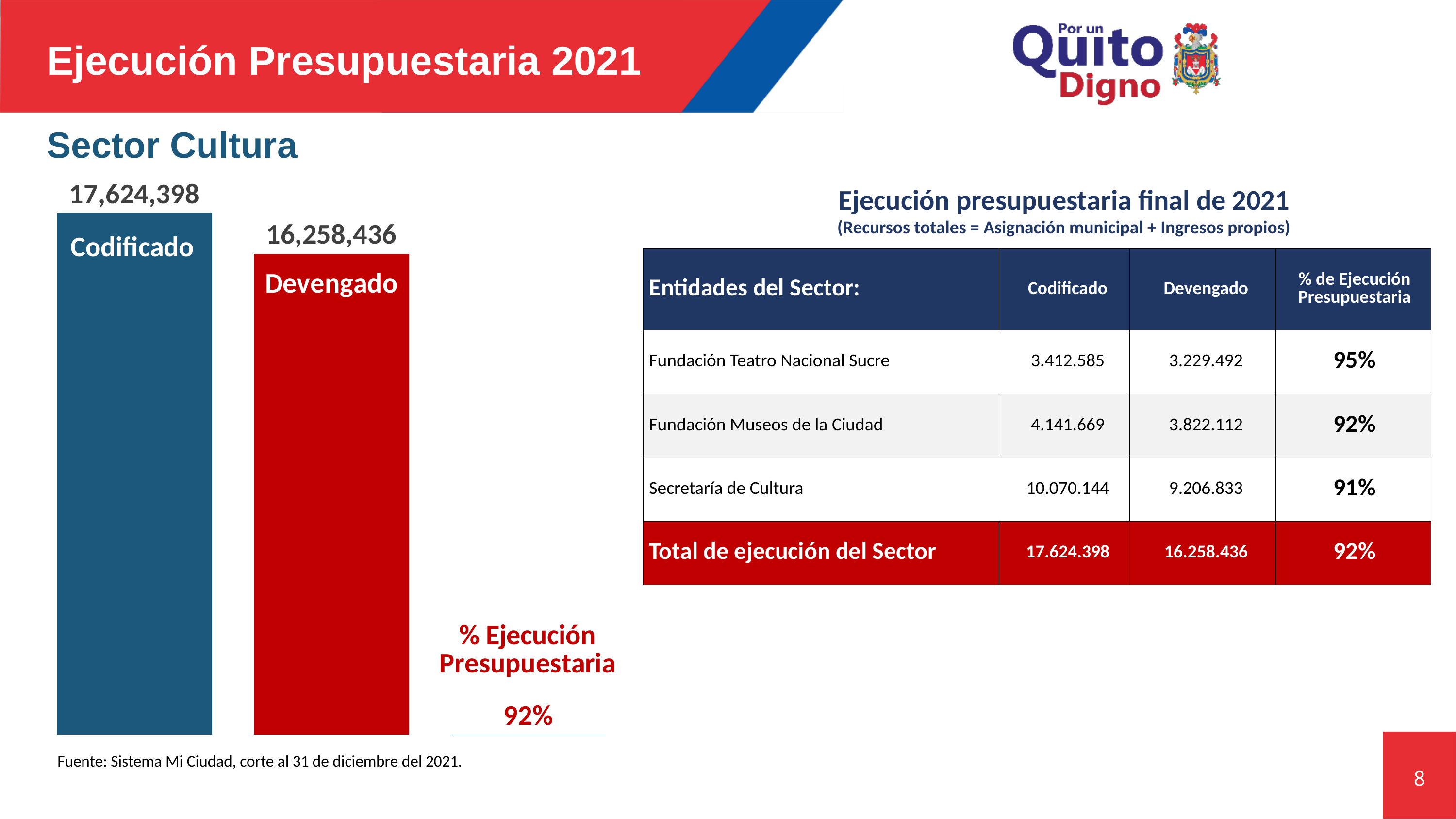
Which bar is taller in the Sector Cultura chart, Codificado or Devengado? Codificado Which bar has the highest value in the Sector Cultura chart? Codificado What is the value of the Devengado bar in the Sector Cultura chart? 16,258,436 What percentage of budget execution (% Ejecución Presupuestaria) is shown next to the Sector Cultura bar chart? 92% What colour is the Devengado bar in the Sector Cultura chart? Red What is the value of the Codificado bar in the Sector Cultura chart? 17,624,398 What is the difference between the Codificado and Devengado values in the Sector Cultura chart? 1,365,962 What type of chart is shown on the left of the slide? Bar chart Which bar has the lowest value in the Sector Cultura chart? Devengado How many bars are shown in the Sector Cultura chart? 2 What colour is the Codificado bar in the Sector Cultura chart? Blue